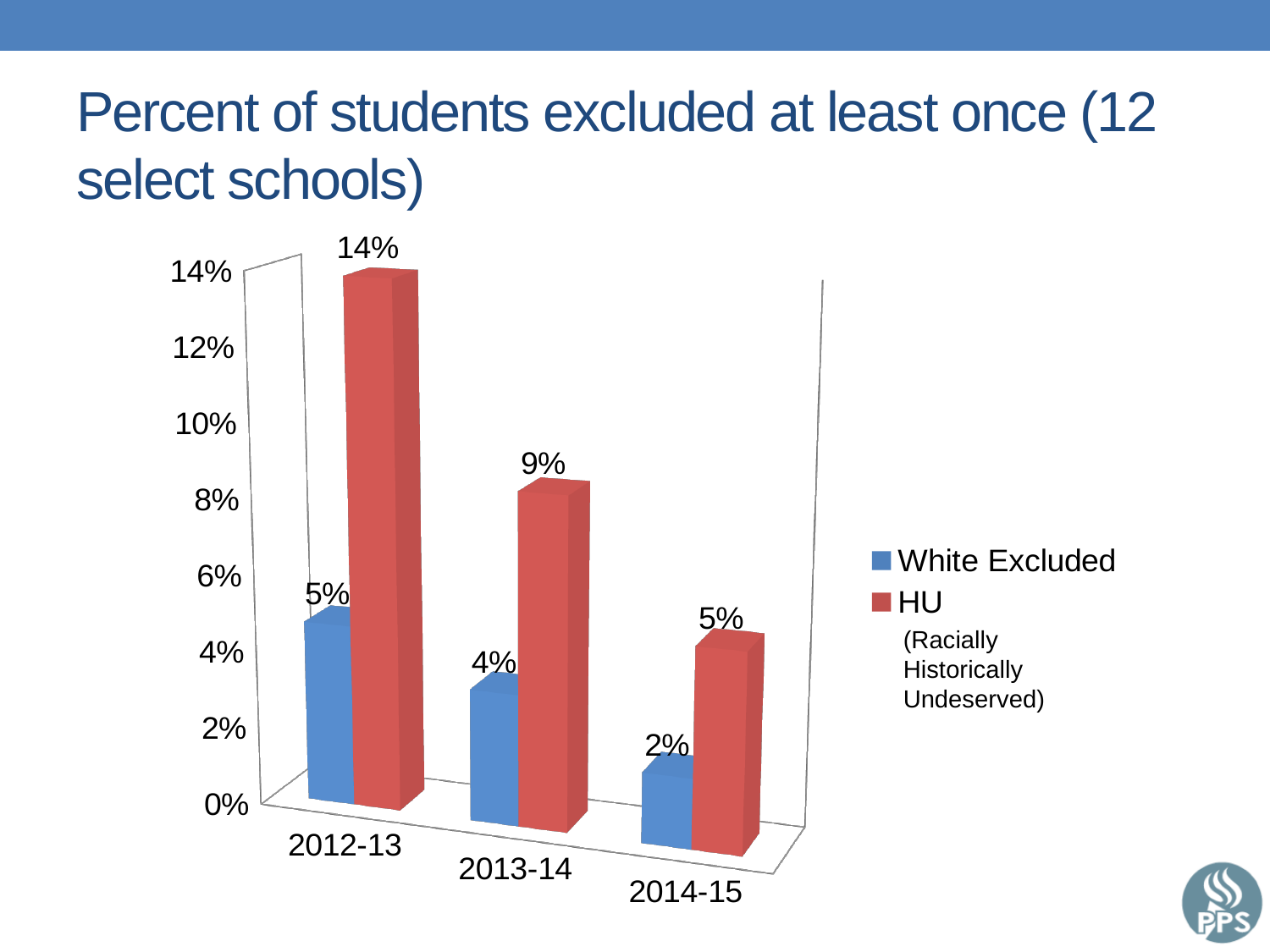
What is the HU value for 2012-13? 14% Do the HU values rise or fall from 2012-13 to 2014-15? Fall What is the difference between the HU and White Excluded values in 2012-13? 9% What kind of chart is shown on the slide? Bar chart What is the HU value for 2014-15? 5% How many series does the legend list? 2 In which year is the HU value highest? 2012-13 What is the White Excluded value for 2013-14? 4% In which year is the White Excluded value lowest? 2014-15 Which is larger in 2013-14, the HU value or the White Excluded value? HU How many years are shown on the x axis? 3 What is the White Excluded value for 2014-15? 2%